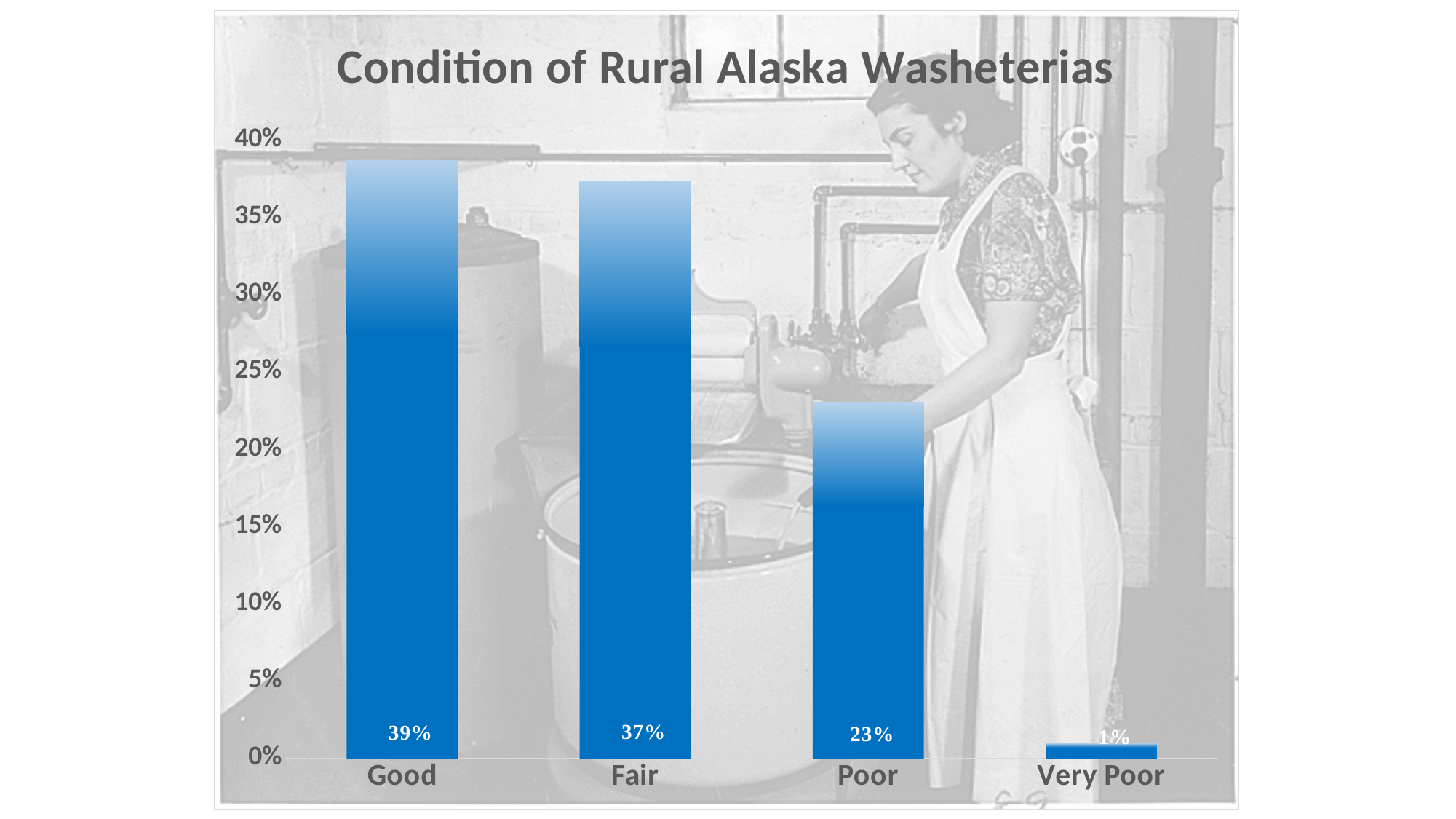
What is the difference in percentage points between the Good and Poor categories? 16% What kind of chart is shown on the slide? Bar chart What percentage of rural Alaska washeterias are in Good condition? 39% Which condition category has the highest percentage? Good Which condition category has the lowest percentage? Very Poor What percentage of rural Alaska washeterias are in Poor condition? 23% What percentage of rural Alaska washeterias are in Very Poor condition? 1% Which is larger, the value for Fair or the value for Poor? Fair What is the title of the chart? Condition of Rural Alaska Washeterias Is the value for Poor greater or less than 25%? less What percentage of rural Alaska washeterias are in Fair condition? 37% How many condition categories are shown on the chart? 4